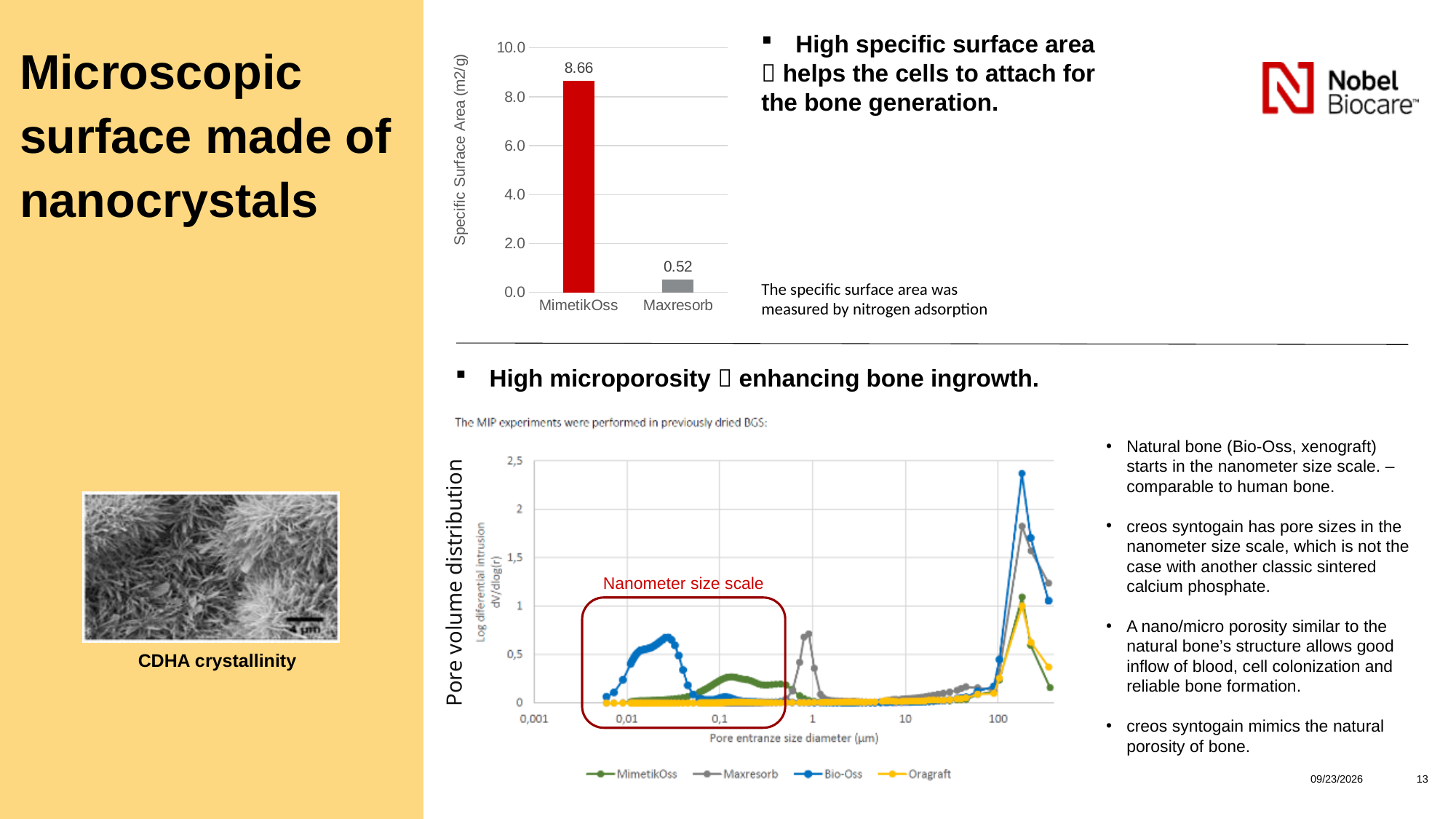
What type of chart is the specific surface area chart at the top of the slide? Bar chart In the bar chart at the top of the slide, what is the difference between the specific surface area of MimetikOss and Maxresorb? 8.14 In the pore volume distribution chart at the bottom of the slide, how many series does the legend list? 4 In the pore volume distribution chart at the bottom of the slide, is the highest peak of the Bio-Oss series greater or less than 2? greater In the pore volume distribution chart at the bottom of the slide, what is the label of the horizontal axis? Pore entranze size diameter (µm) In the pore volume distribution chart at the bottom of the slide, which series reaches the highest peak? Bio-Oss In the bar chart at the top of the slide, what is the label of the vertical axis? Specific Surface Area (m2/g) In the bar chart at the top of the slide, which material has the higher specific surface area? MimetikOss In the bar chart at the top of the slide, what is the specific surface area of Maxresorb? 0.52 In the bar chart at the top of the slide, how many materials are compared? 2 In the bar chart at the top of the slide, is the value for MimetikOss greater or less than 8.0? greater In the bar chart at the top of the slide, what is the specific surface area of MimetikOss? 8.66